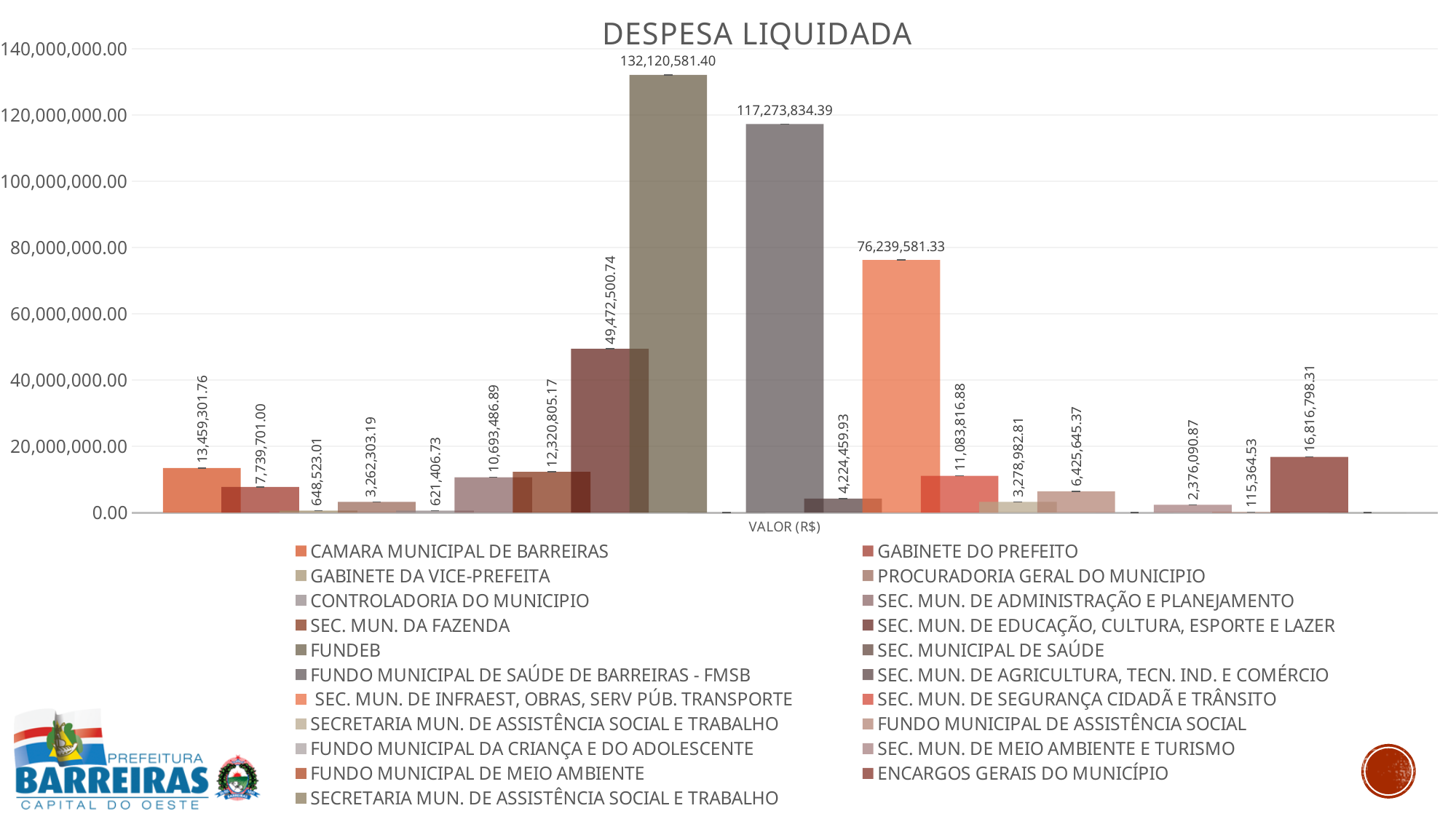
What is the smallest value printed as a data label on the chart? 115,364.53 Is the value for FUNDEB greater or less than 120,000,000.00? greater What is the value of the second tallest bar in the chart? 117,273,834.39 What is the difference between the first bar (13,459,301.76) and the second bar (7,739,701.00)? 5,719,600.76 What type of chart is shown on the slide? bar chart What is the difference between the two tallest bars (132,120,581.40 and 117,273,834.39)? 14,846,747.01 What is the label shown on the horizontal axis? VALOR (R$) What is the title of the chart? DESPESA LIQUIDADA Which is larger: the bar labelled 76,239,581.33 or the bar labelled 49,472,500.74? 76,239,581.33 Which series has the tallest bar in the chart? FUNDEB How many series does the legend list? 21 What is the highest value labelled on the chart? 132,120,581.40